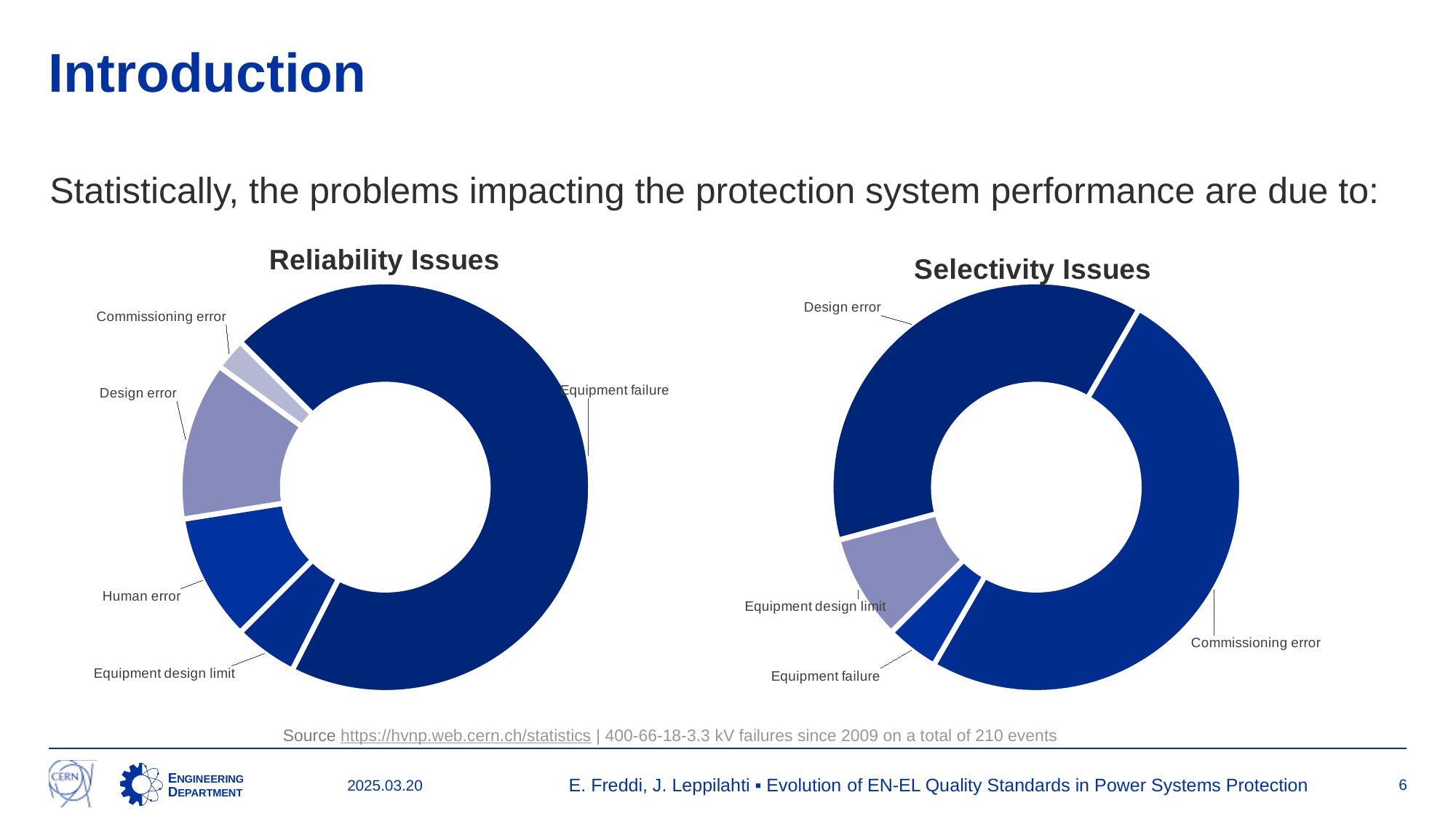
In the Selectivity Issues chart, which category has the largest slice? Commissioning error What kind of chart is the Selectivity Issues chart? doughnut chart How many categories are shown in the Selectivity Issues chart? 4 In the Selectivity Issues chart, which slice is larger: Design error or Equipment design limit? Design error In the Selectivity Issues chart, which category has the smallest slice? Equipment failure What is the title of the chart on the left side of the slide? Reliability Issues In the Reliability Issues chart, which slice is larger: Design error or Human error? Design error In the Reliability Issues chart, which category has the smallest slice? Commissioning error What is the title of the chart on the right side of the slide? Selectivity Issues In the Reliability Issues chart, which category has the largest slice? Equipment failure How many categories are shown in the Reliability Issues chart? 5 What kind of chart is the Reliability Issues chart? doughnut chart